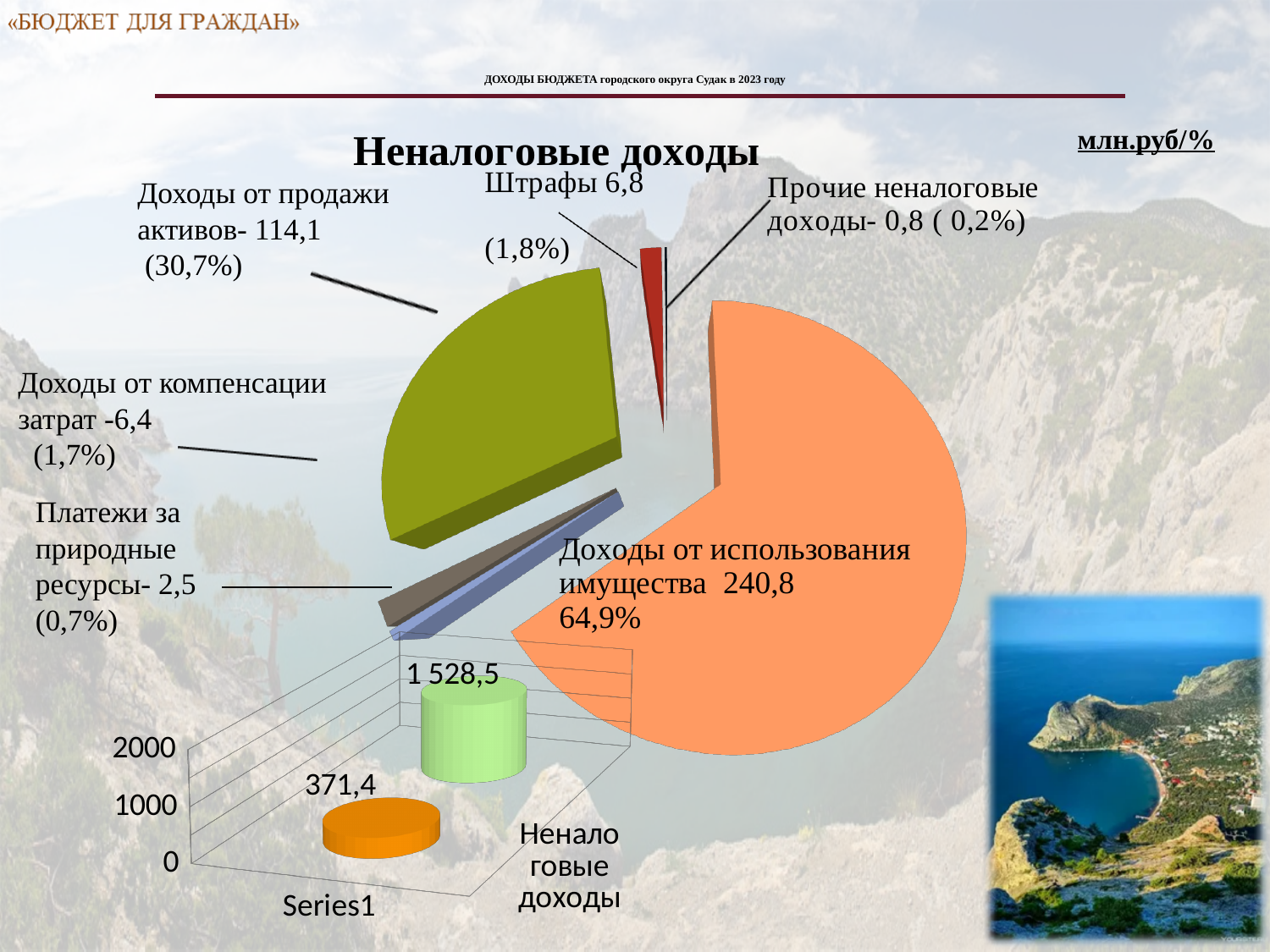
On the pie chart 'Неналоговые доходы', which category has the largest slice? Доходы от использования имущества On the bar chart at the bottom left, what is the value of the green bar? 1 528,5 On the pie chart 'Неналоговые доходы', what is the value for 'Штрафы'? 6,8 On the pie chart 'Неналоговые доходы', what is the value for 'Прочие неналоговые доходы'? 0,8 On the pie chart 'Неналоговые доходы', what is the difference between 'Доходы от использования имущества' and 'Доходы от продажи активов'? 126,7 What type of chart is the small chart at the bottom left of the slide? bar chart On the pie chart 'Неналоговые доходы', which is larger: 'Доходы от компенсации затрат' or 'Платежи за природные ресурсы'? Доходы от компенсации затрат On the pie chart 'Неналоговые доходы', what share does 'Платежи за природные ресурсы' have? 0,7% On the pie chart 'Неналоговые доходы', which category has the smallest slice? Прочие неналоговые доходы On the pie chart 'Неналоговые доходы', what share does 'Доходы от продажи активов' have? 30,7% On the pie chart 'Неналоговые доходы', how many slices are there? 6 On the pie chart 'Неналоговые доходы', what is the value for 'Доходы от использования имущества'? 240,8